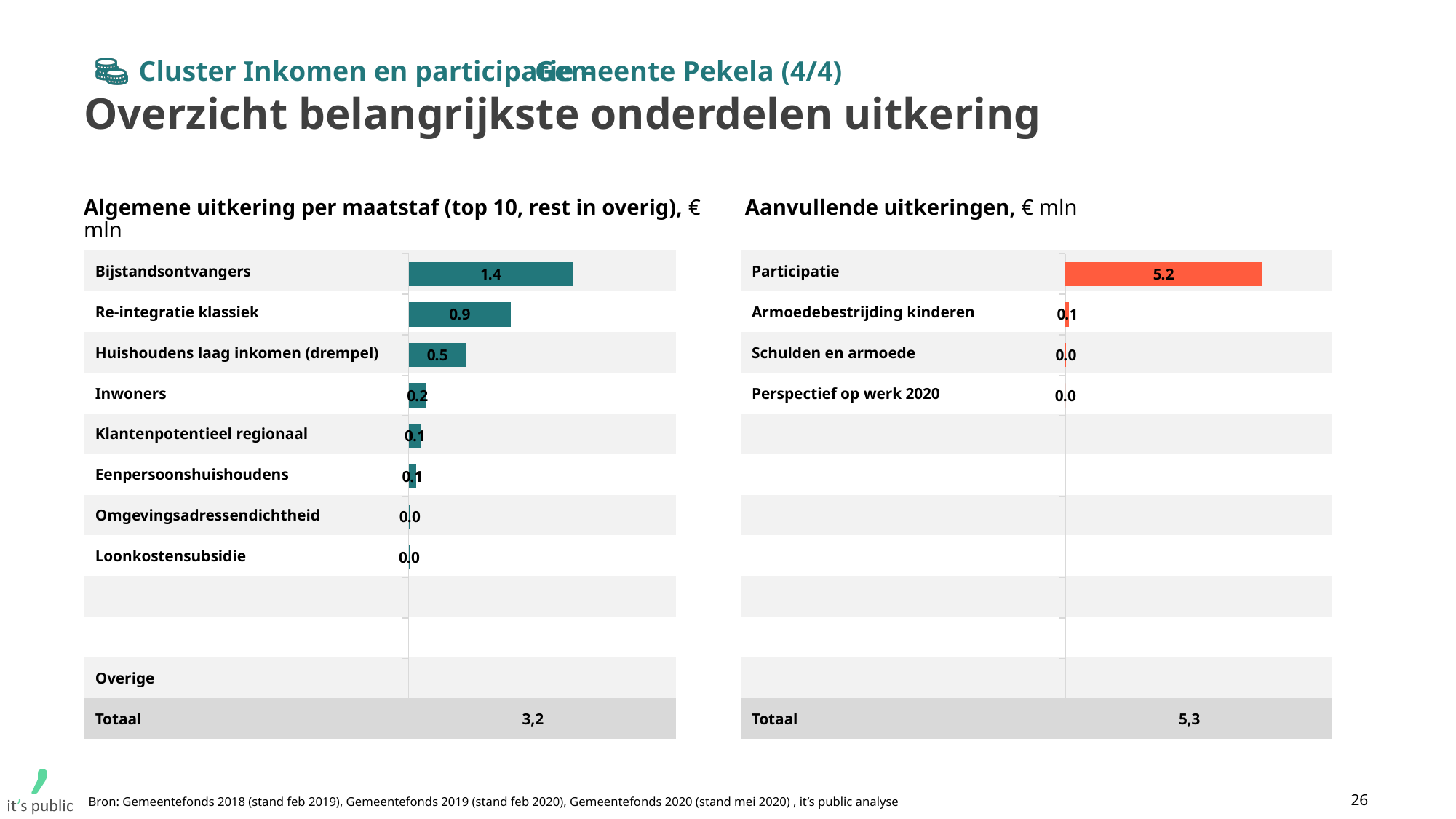
How many categories are plotted in the 'Aanvullende uitkeringen' chart? 4 In the 'Aanvullende uitkeringen' chart, which category has the highest value? Participatie In the 'Aanvullende uitkeringen' chart, what is the difference between Participatie and Armoedebestrijding kinderen? 5.1 In the 'Algemene uitkering per maatstaf' chart, which category has the highest value? Bijstandsontvangers In the 'Aanvullende uitkeringen' chart, what is the value for Participatie? 5.2 In the 'Algemene uitkering per maatstaf' chart, what is the value for Huishoudens laag inkomen (drempel)? 0.5 In the 'Aanvullende uitkeringen' chart, what is the value for Armoedebestrijding kinderen? 0.1 In the 'Algemene uitkering per maatstaf' chart, what is the difference between Bijstandsontvangers and Re-integratie klassiek? 0.5 In the 'Algemene uitkering per maatstaf' chart, what is the value for Bijstandsontvangers? 1.4 In the 'Algemene uitkering per maatstaf' chart, which is larger: Re-integratie klassiek or Inwoners? Re-integratie klassiek What type of chart is the 'Algemene uitkering per maatstaf' chart? Bar chart What is the Totaal shown at the bottom of the 'Aanvullende uitkeringen' chart? 5,3